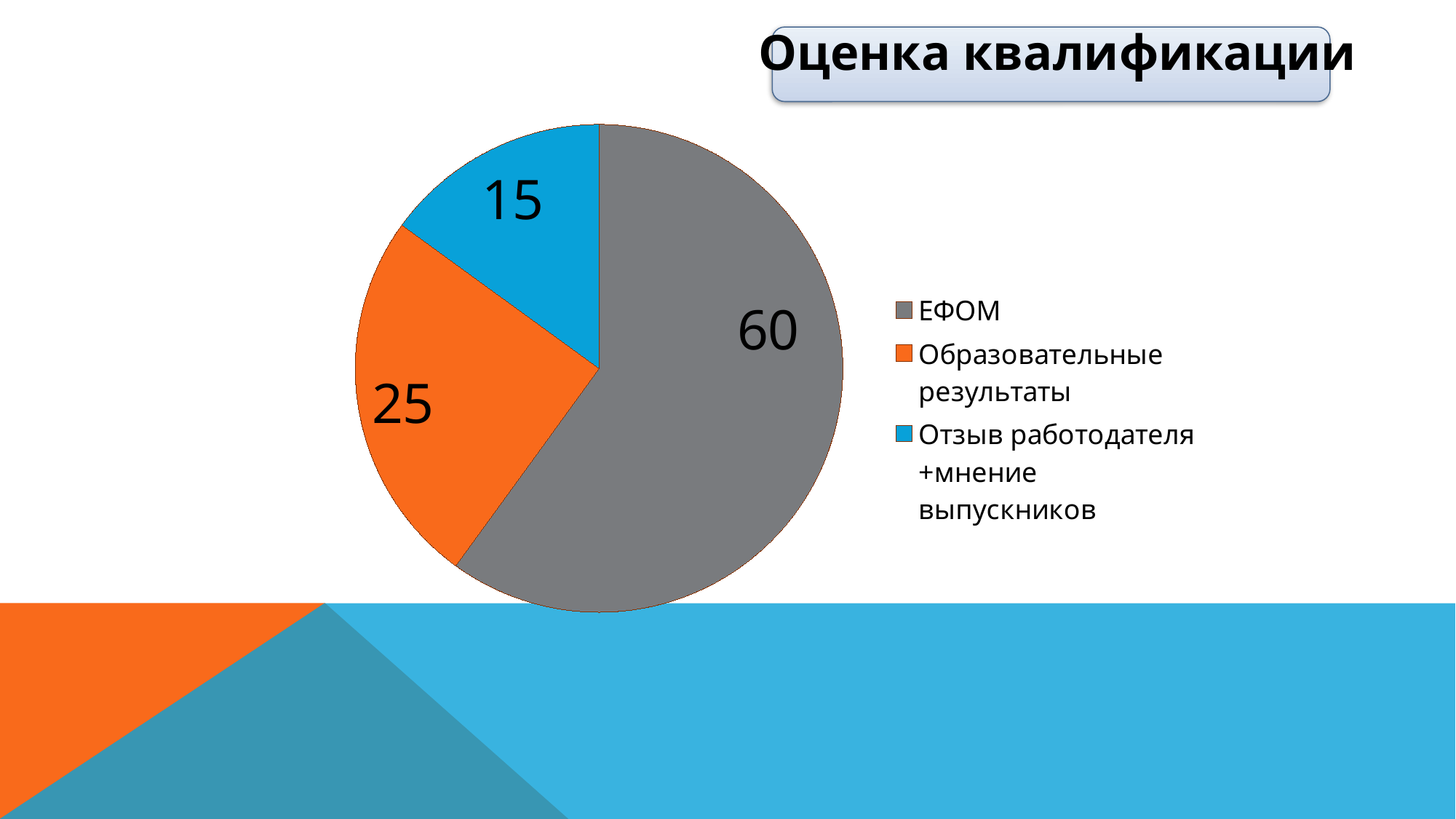
How many slices does the pie chart have? 3 What is the difference between the values for ЕФОМ and Образовательные результаты? 35 What is the value for Образовательные результаты? 25 What share of the pie does ЕФОМ represent? 60% Which is larger, the value for Образовательные результаты or the value for Отзыв работодателя +мнение выпускников? Образовательные результаты Which category has the largest slice? ЕФОМ Which category has the smallest slice? Отзыв работодателя +мнение выпускников What is the value for ЕФОМ? 60 What is the value for Отзыв работодателя +мнение выпускников? 15 What is the difference between the values for Образовательные результаты and Отзыв работодателя +мнение выпускников? 10 What colour is the slice for Образовательные результаты? orange What kind of chart is shown on the slide? pie chart